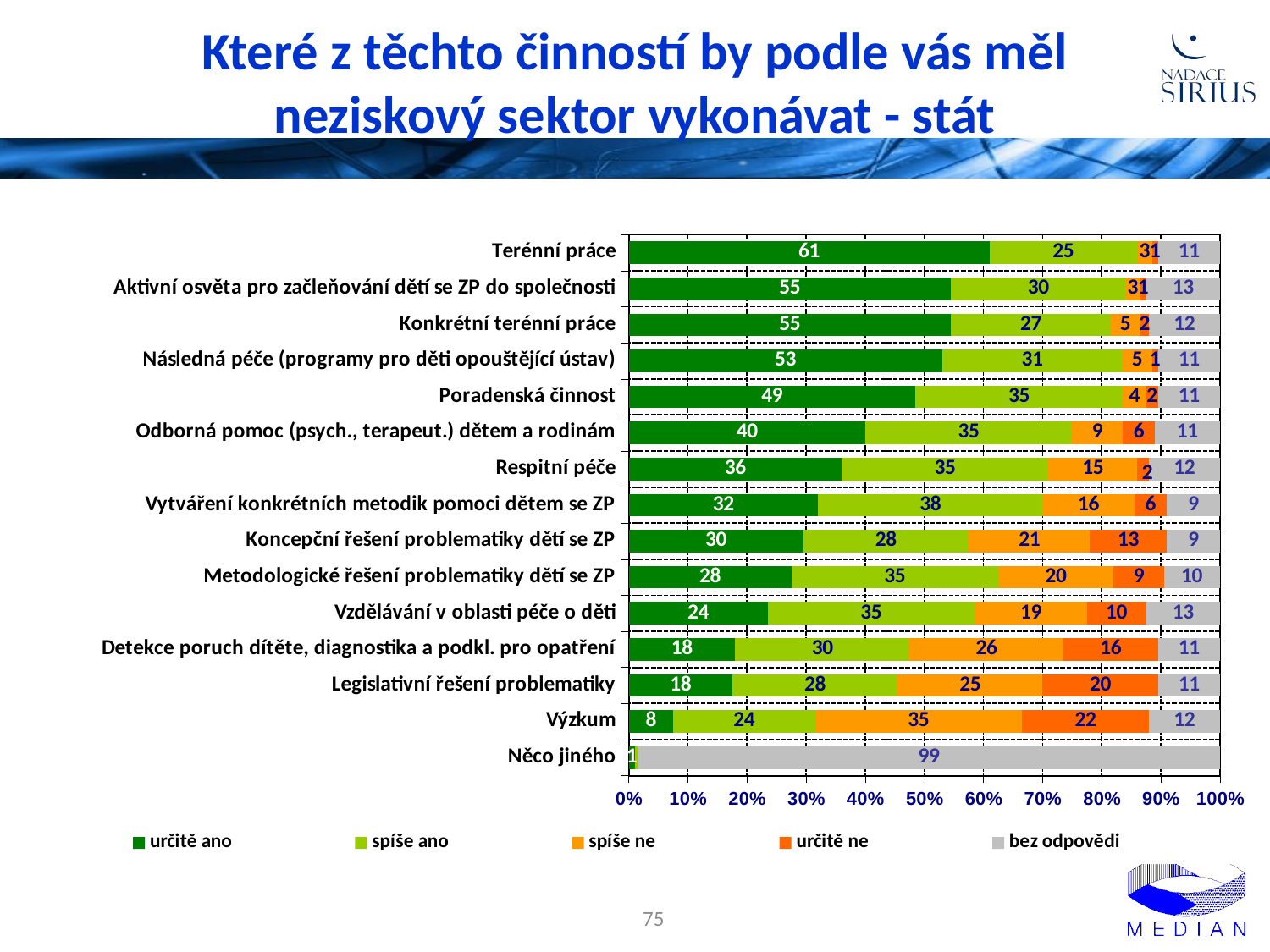
What kind of chart is shown on the slide? Stacked bar chart How many series does the legend list? 5 What is the 'spíše ano' value for Vytváření konkrétních metodik pomoci dětem se ZP? 38 Which category has the highest 'určitě ano' value? Terénní práce How many categories are shown in the chart? 15 What is the difference between the 'určitě ano' values for Terénní práce and Výzkum? 53 What is the 'bez odpovědi' value for Něco jiného? 99 What is the 'spíše ne' value for Výzkum? 35 Which category has the lowest 'určitě ano' value? Něco jiného What is the 'určitě ano' value for Terénní práce? 61 Which is larger: the 'určitě ne' value for Legislativní řešení problematiky or for Koncepční řešení problematiky dětí se ZP? Legislativní řešení problematiky Is the 'určitě ano' value for Poradenská činnost greater or less than 40%? greater